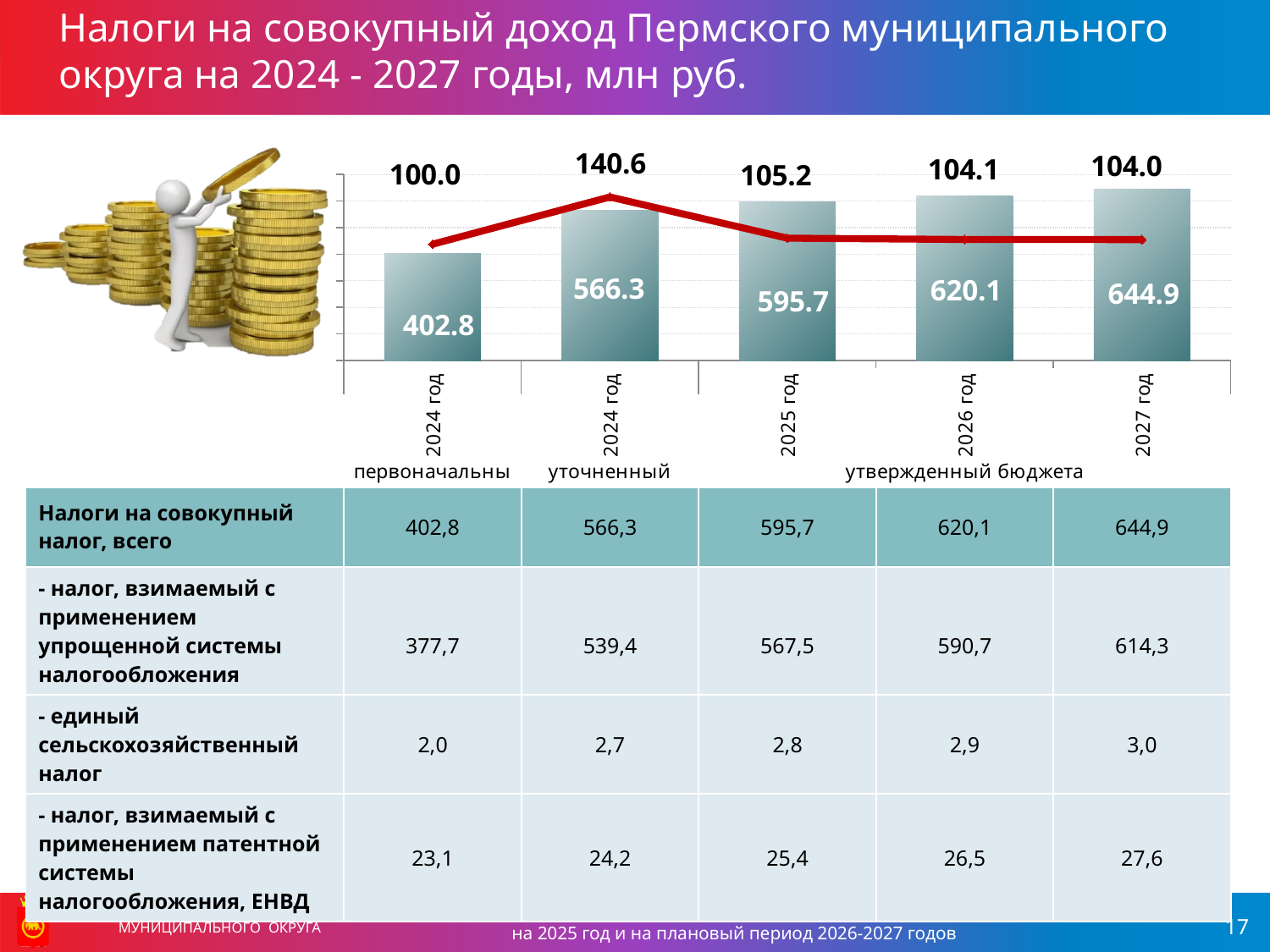
How many categories are shown on the x axis? 5 What is the difference between the line values for 2024 год уточненный and 2024 год первоначальный? 40.6 What is the value shown on the line for 2024 год уточненный? 140.6 Which bar is larger, 2026 год or 2025 год? 2026 год What is the bar value for 2026 год? 620.1 Do the bar values rise or fall from left to right along the x axis? Rise Which category has the lowest bar? 2024 год первоначальный What is the bar value for 2025 год? 595.7 Which category has the highest value on the line? 2024 год уточненный Which category has the highest bar? 2027 год What is the difference between the bar values for 2027 год and 2024 год первоначальный? 242.1 What kind of chart is this? Bar chart with a line